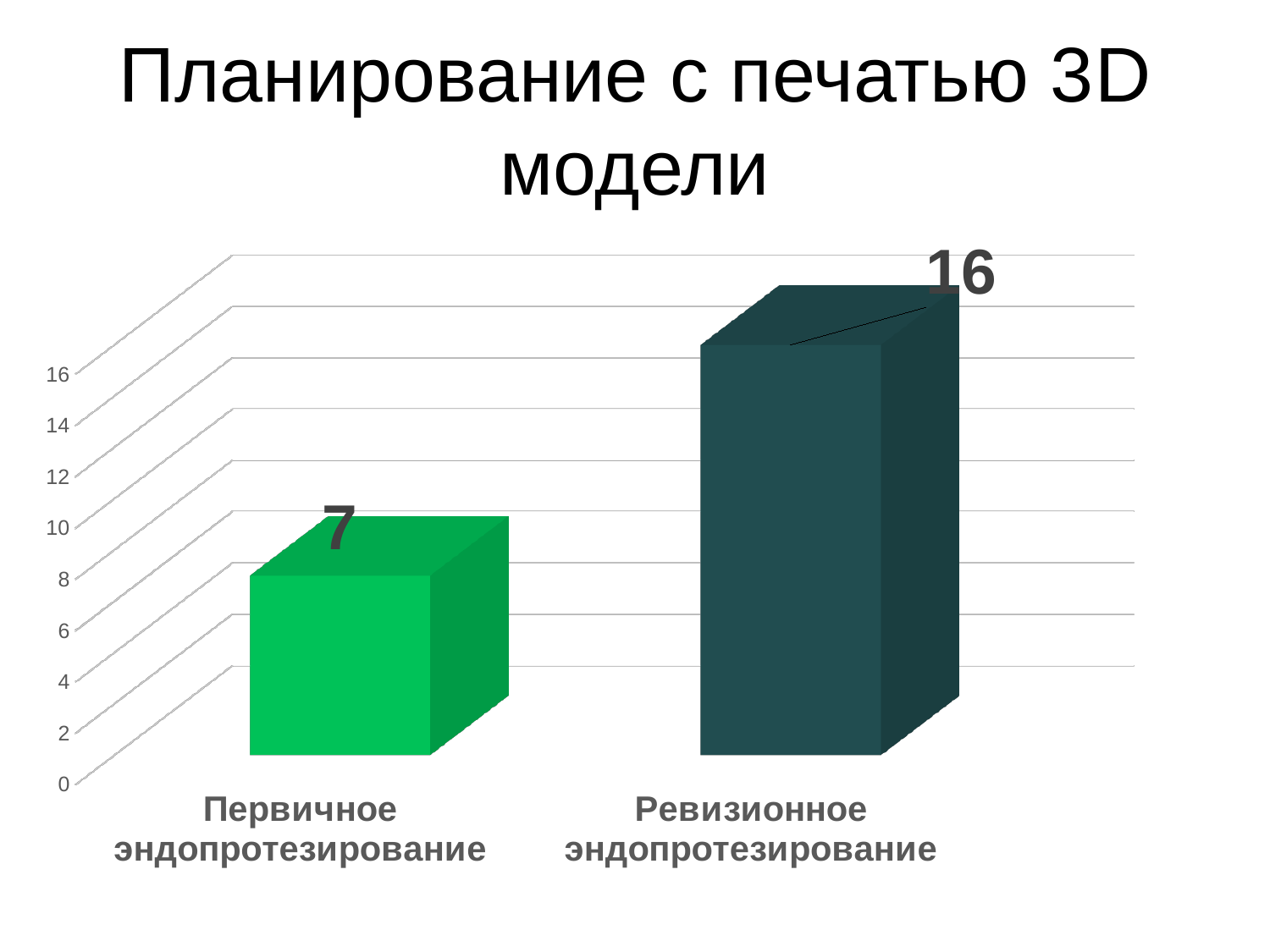
How many categories are shown in the chart? 2 Which category has the lowest value? Первичное эндопротезирование Is the value for Первичное эндопротезирование greater or less than 10? less What is the value for Первичное эндопротезирование? 7 Is the value for Ревизионное эндопротезирование greater or less than 10? greater Which category has the highest value? Ревизионное эндопротезирование Which is larger: the value for Первичное эндопротезирование or the value for Ревизионное эндопротезирование? Ревизионное эндопротезирование What is the value for Ревизионное эндопротезирование? 16 What is the title of the slide? Планирование с печатью 3D модели What is the highest tick value shown on the vertical axis? 16 What is the difference between the values for Ревизионное эндопротезирование and Первичное эндопротезирование? 9 What kind of chart is shown on the slide? bar chart